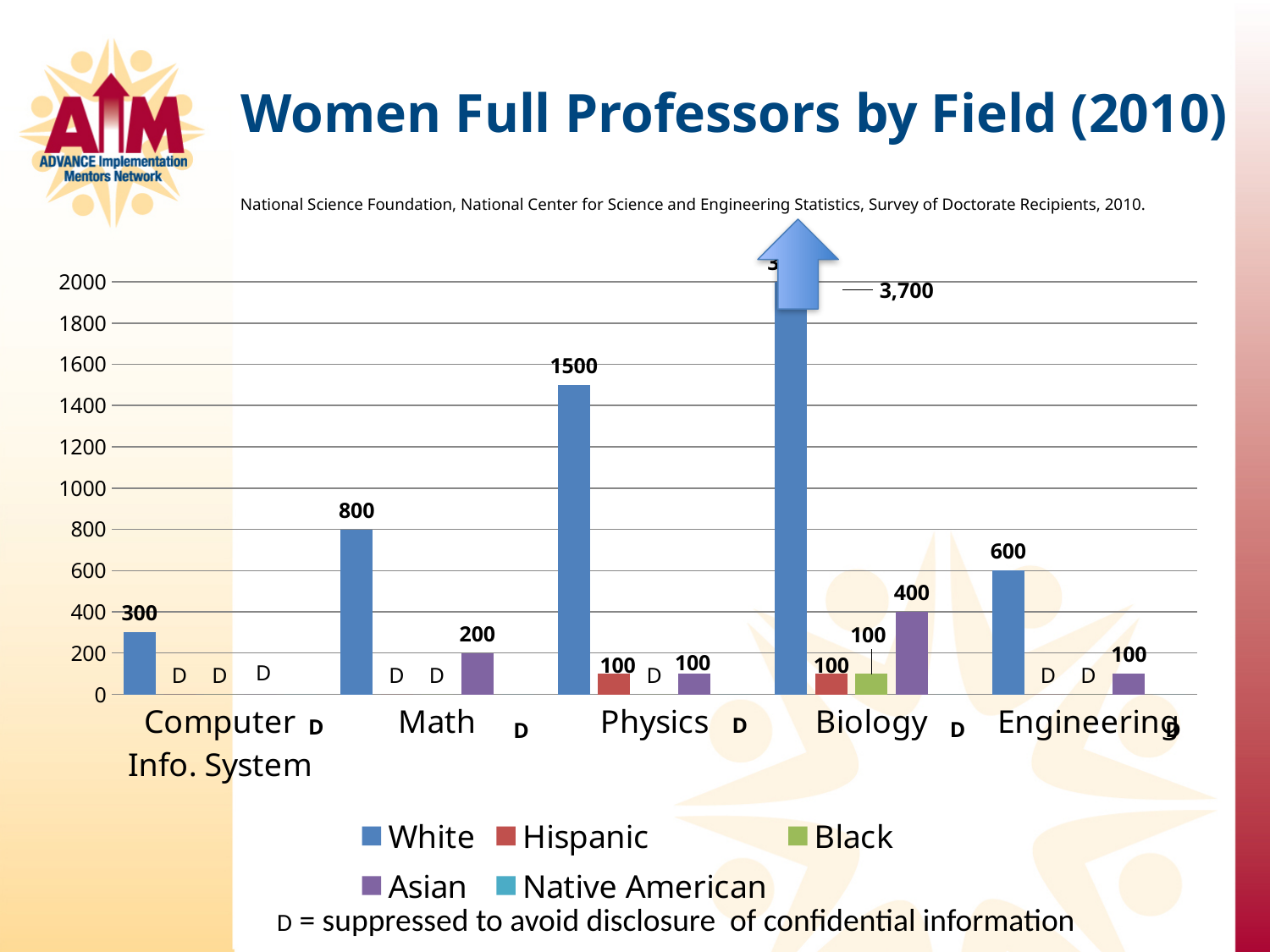
How many series does the legend list? 5 Which field has the lowest value for the White series? Computer Info. System According to the note on the slide, what does "D" stand for? suppressed to avoid disclosure of confidential information What is the value for White women full professors in Physics? 1500 What is the difference between the White values for Physics and Math? 700 Which is larger, the White value for Engineering or the White value for Math? Math What is the value for White women full professors in Biology? 3,700 Which field has the highest value for the White series? Biology What is the value for Asian women full professors in Biology? 400 What is the value for Asian women full professors in Math? 200 What type of chart is shown on the slide? bar chart How many fields (categories) are shown on the x axis? 5